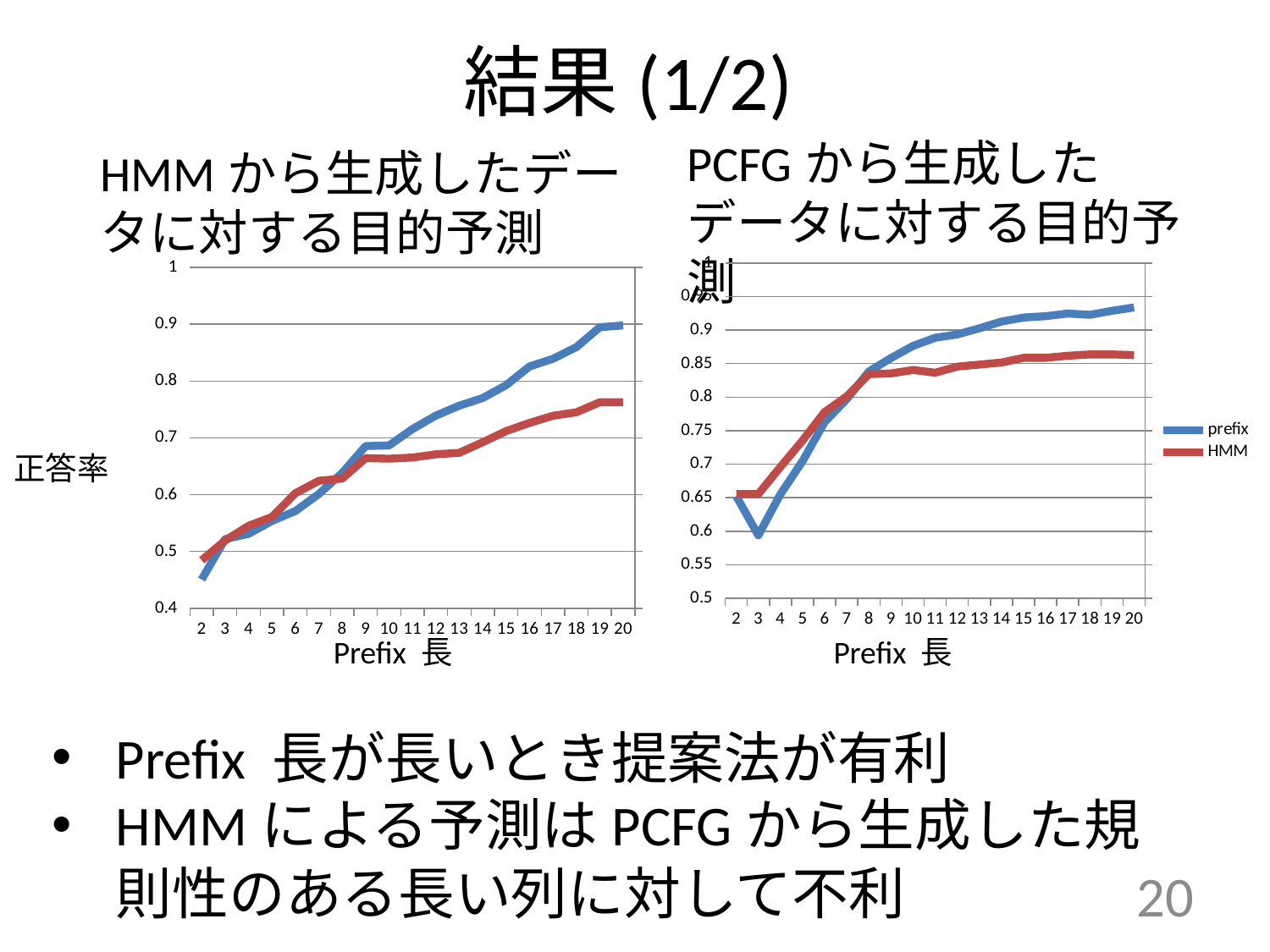
In the left chart (HMM から生成したデータ), is the prefix value at Prefix 長 20 greater or less than 0.8? greater How many series does the legend of the right chart (PCFG から生成したデータに対する目的予測) list? 2 In the left chart (HMM から生成したデータ), which series is higher at Prefix 長 20, prefix or HMM? prefix In the right chart (PCFG から生成したデータ), is the prefix value at Prefix 長 20 greater or less than 0.9? greater What are the two series names shown in the legend of the right chart? prefix, HMM How many Prefix 長 values are plotted along the x axis of the left chart? 19 What kind of chart is the left chart (HMM から生成したデータに対する目的予測)? line chart In the right chart (PCFG から生成したデータ), is the prefix value at Prefix 長 3 greater or less than 0.65? less In the left chart (HMM から生成したデータ), does the prefix series generally rise or fall as Prefix 長 increases? rise In the right chart (PCFG から生成したデータ), which series is higher at Prefix 長 20, prefix or HMM? prefix